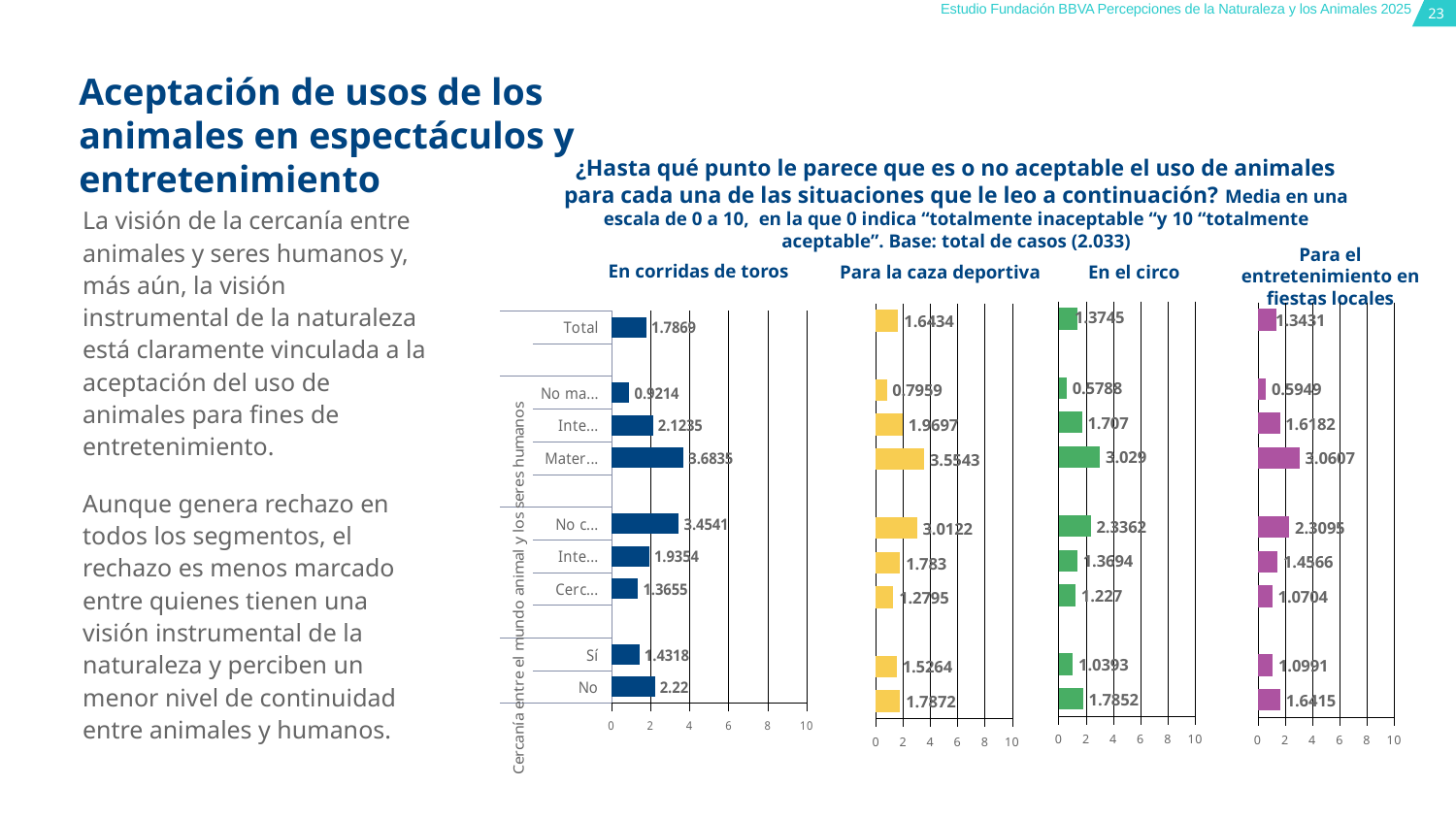
In the 'En el circo' chart, which has the larger value, 'Sí' or 'No'? No In the 'En corridas de toros' chart, what is the value for Total? 1.7869 In the 'En corridas de toros' chart, what is the highest value shown? 3.6835 What kind of chart is used for 'En el circo'? bar chart In the 'En el circo' chart, what is the lowest value shown? 0.5788 How many bars are plotted in the 'Para la caza deportiva' chart? 9 In the 'En corridas de toros' chart, what is the difference between the values for 'No' and 'Sí'? 0.7882 In the 'Para la caza deportiva' chart, what is the value for the 'No' category? 1.7872 In the 'En el circo' chart, what is the value for the 'Sí' category? 1.0393 In the 'En corridas de toros' chart, is the value for Total greater or less than 2? less How many charts are shown on the slide? 4 In the 'Para el entretenimiento en fiestas locales' chart, what is the value for Total? 1.3431